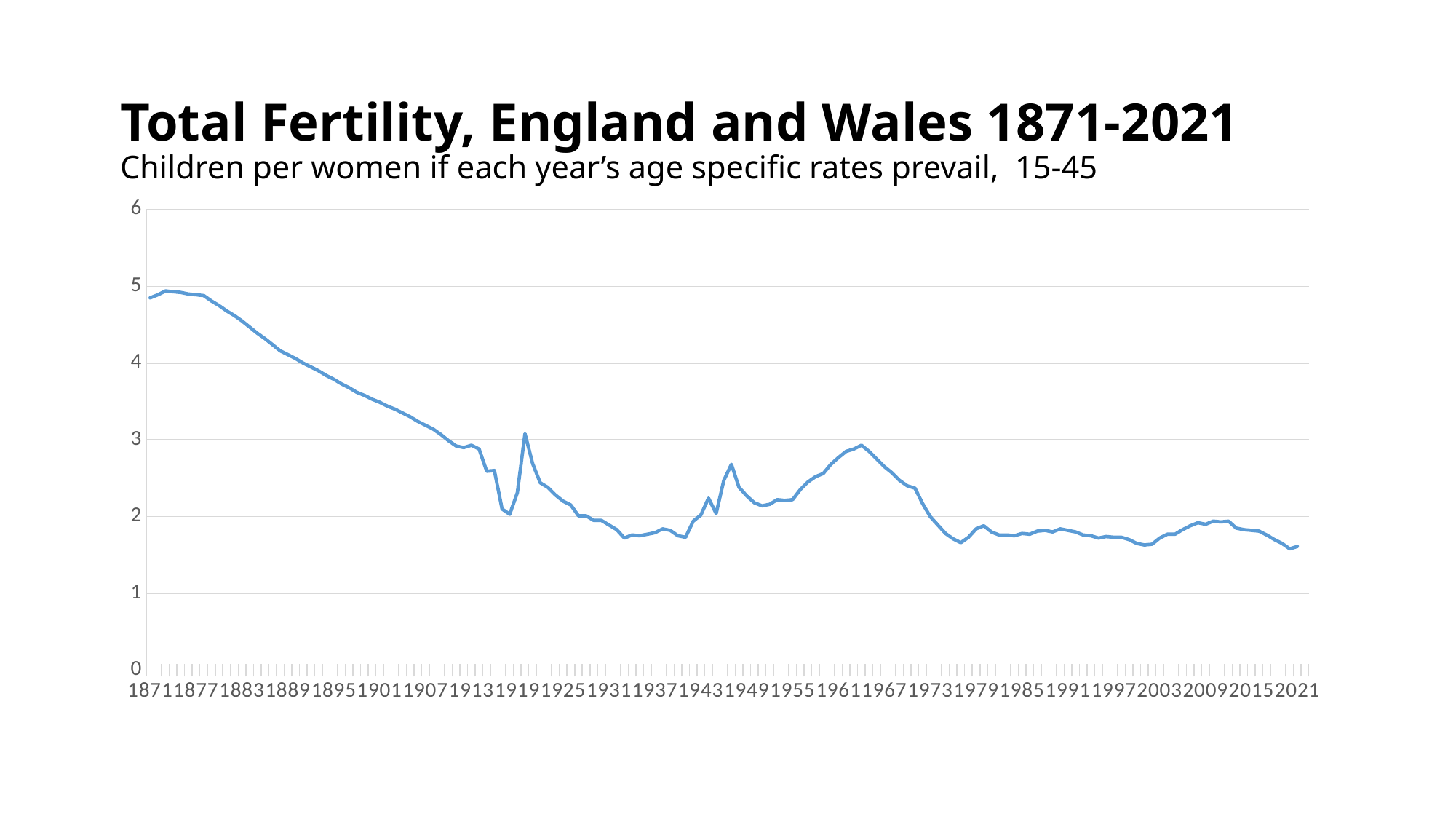
Is the value for 1901 greater or less than 3? greater Is the value for 1931 greater or less than 2? less Is the value for 1871 larger or smaller than the value for 1961? larger Do the values rise or fall between 1871 and 1913? fall Is the value for 1871 greater or less than 4? greater Is the highest value of the series at the beginning or the end of the period shown? beginning What is the subtitle shown under the chart title? Children per women if each year's age specific rates prevail, 15-45 What is the title of the chart? Total Fertility, England and Wales 1871-2021 What kind of chart is shown on the slide? line chart Overall, do the values rise or fall from 1871 to 2021? fall